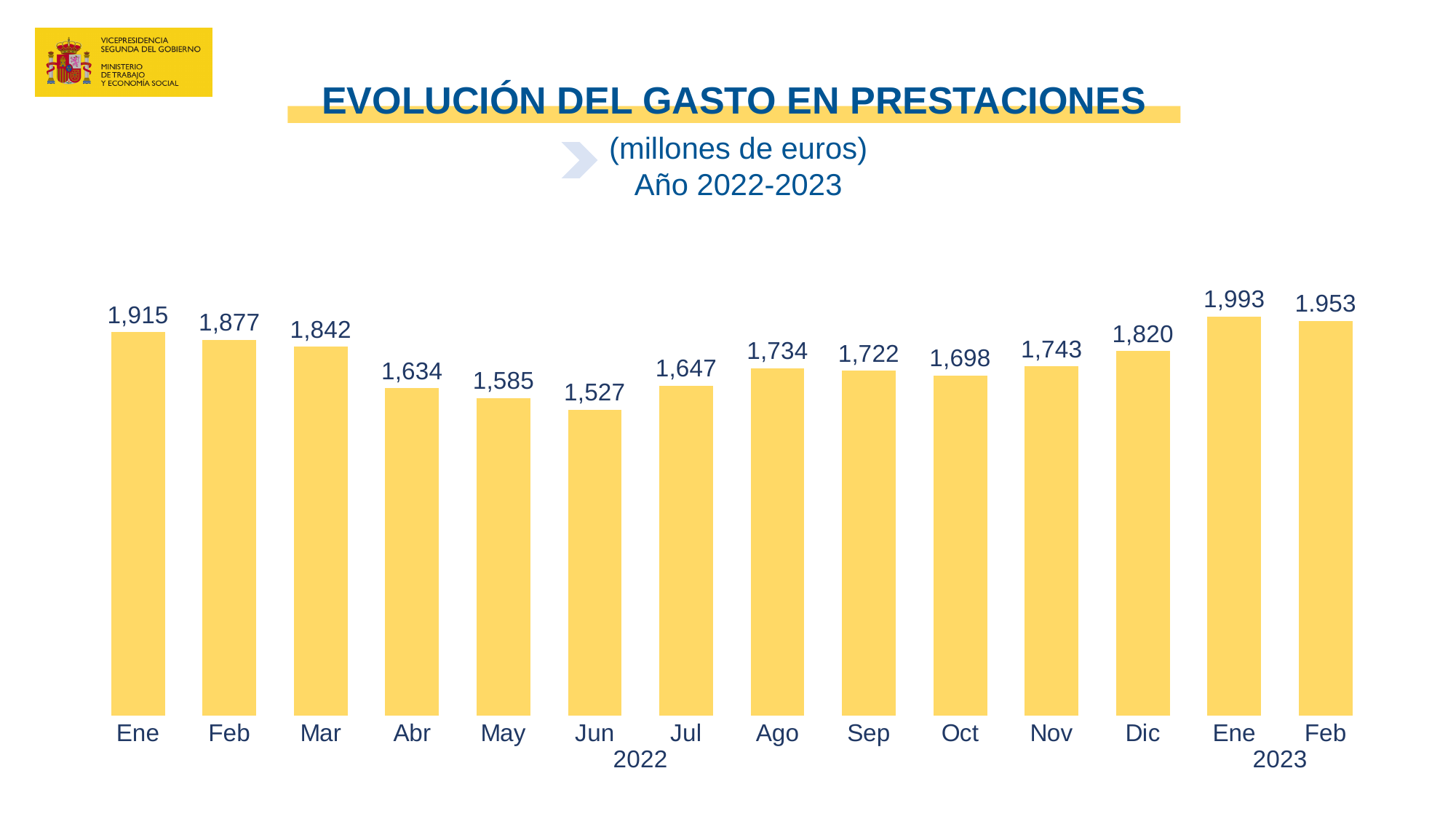
What is the value for Dic 2022? 1,820 How many bars are shown in the chart? 14 In what unit are the values expressed, according to the subtitle? Millones de euros Do the values rise or fall from Ene 2022 to Jun 2022? Fall Which month has the lowest value? Jun 2022 What is the value for Feb 2023? 1.953 What is the value for Jun 2022? 1,527 What kind of chart is shown on the slide? Bar chart What is the difference between the values for Dic 2022 and Nov 2022? 77 What is the difference between the values for Ene 2022 and Feb 2022? 38 Which month has the highest value? Ene 2023 Which is larger, the value for Mar 2022 or the value for Dic 2022? Mar 2022